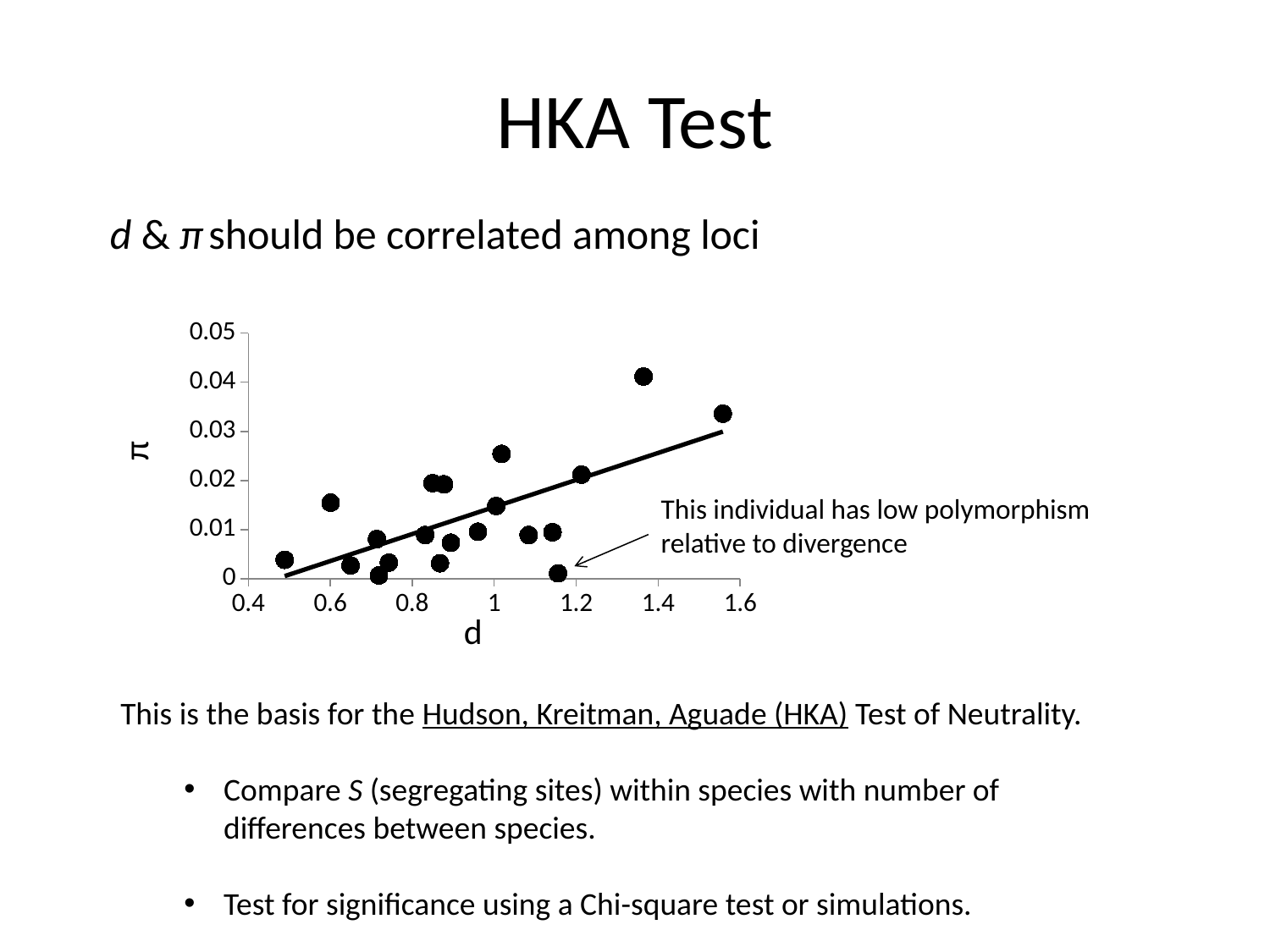
What is the highest value shown on the y axis of the chart? 0.05 What is the highest value shown on the x axis of the chart? 1.6 Is the π value of the point indicated by the arrow (the individual with low polymorphism) greater or less than 0.01? less Does the fitted line in the chart rise or fall as d increases? Rises Is the π value of the point at d ≈ 0.6 greater or less than 0.01? greater What is the label of the x axis of the chart? d Is the π value of the point at d ≈ 1.36 greater or less than 0.03? greater What kind of chart is shown on the slide? Scatter plot Which point has the highest π value: the one at d ≈ 1.36 or the one at d ≈ 1.56? The one at d ≈ 1.36